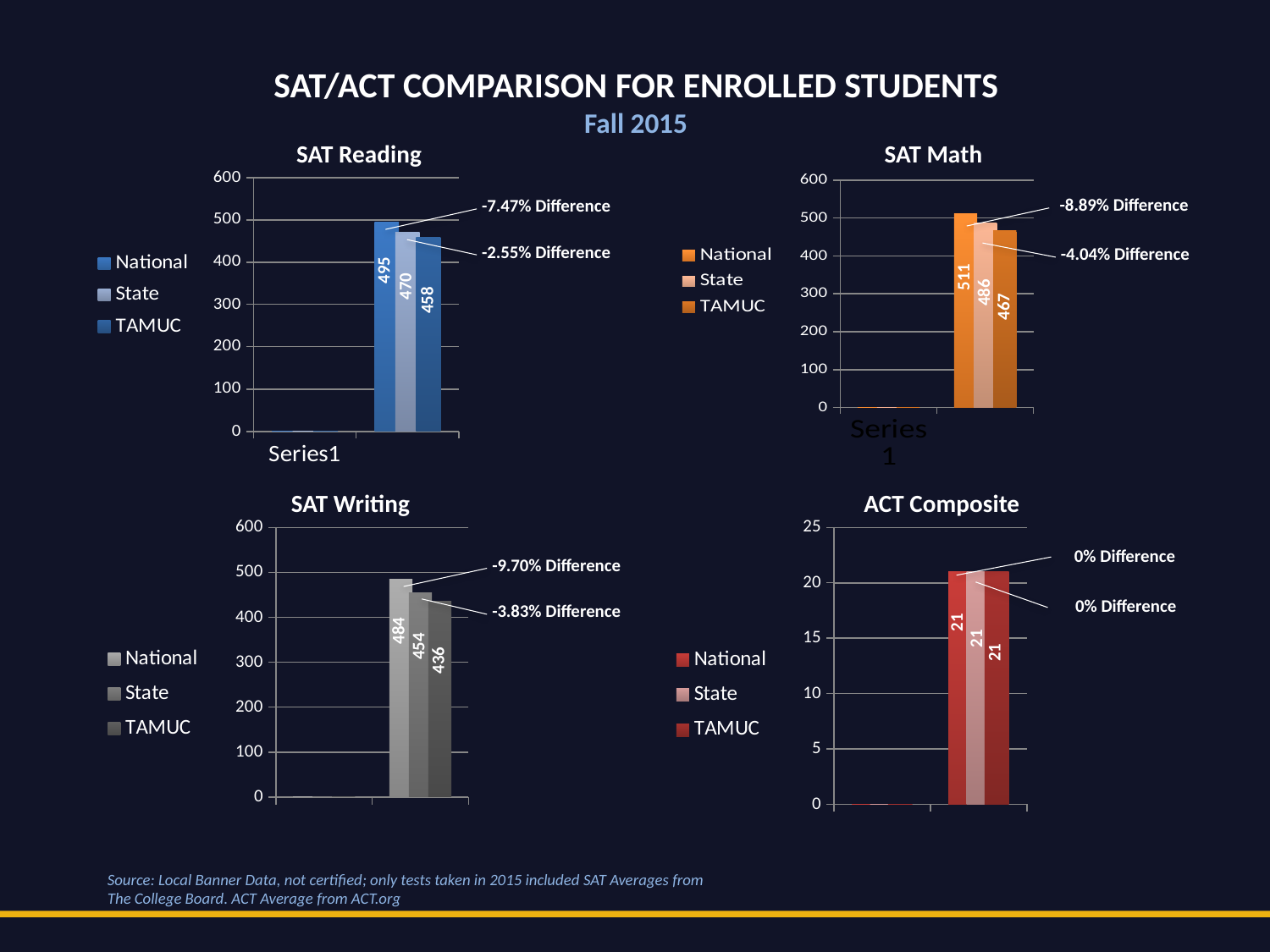
In the SAT Writing chart, which is larger, the National value or the State value? National In the SAT Math chart, what is the value for State? 486 What kind of chart is the ACT Composite chart? Bar chart In the SAT Reading chart, what is the value for TAMUC? 458 In the SAT Writing chart, what is the value for TAMUC? 436 In the SAT Writing chart, which series has the lowest value? TAMUC In the SAT Math chart, which series has the highest value? National In the SAT Reading chart, what is the difference between the National and TAMUC values? 37 In the SAT Reading chart, what is the value for National? 495 In the ACT Composite chart, what is the value for National? 21 How many series does the legend of the SAT Reading chart list? 3 In the SAT Math chart, what is the difference between the National and State values? 25